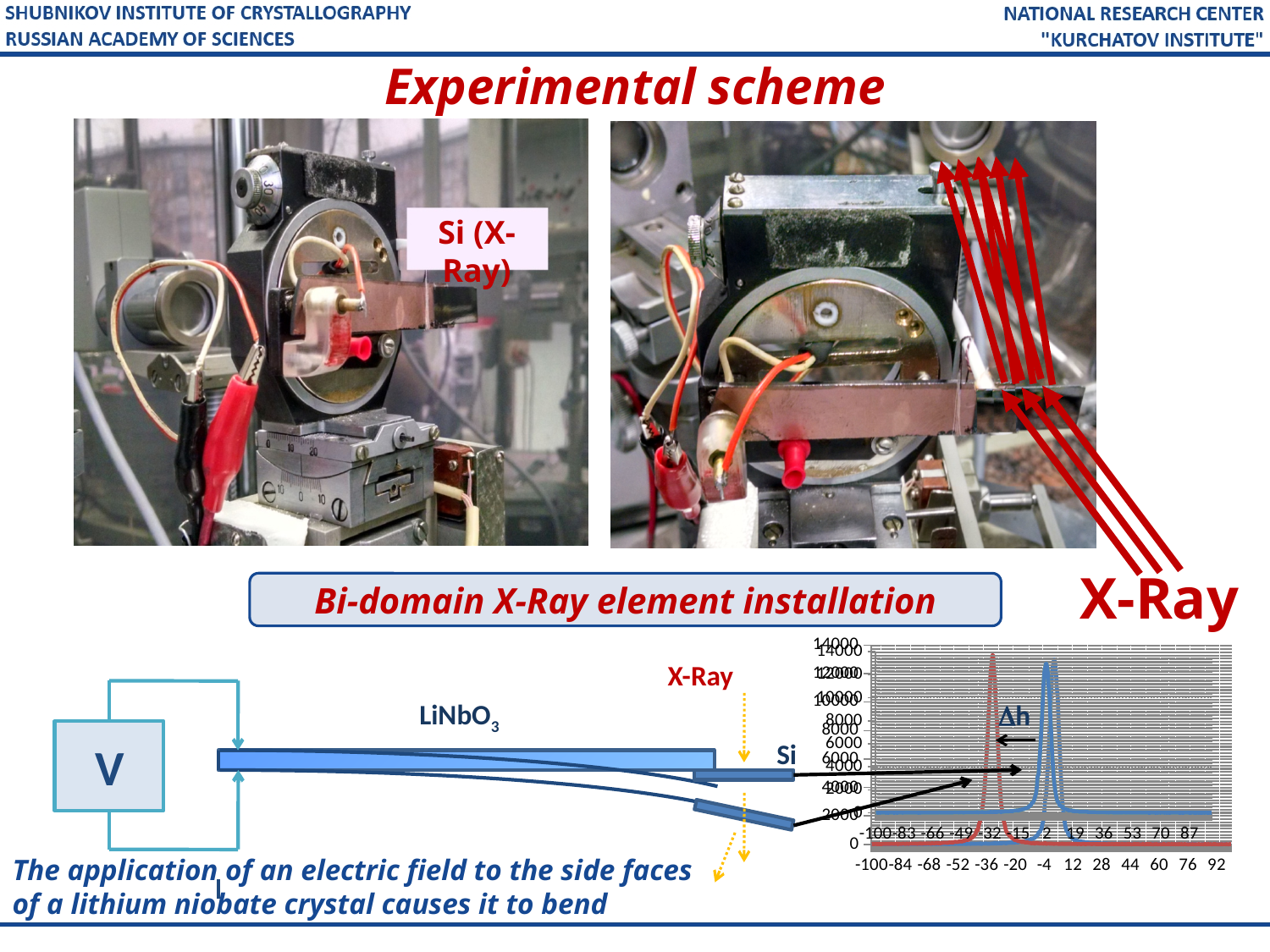
On the chart at the bottom right, what label is written next to the arrow between the two peaks? Δh On the chart at the bottom right, which curve reaches a higher peak, the red dashed curve or the blue solid curve? red dashed curve What kind of chart is shown at the bottom right of the slide? line chart On the chart at the bottom right, is the peak of the blue solid curve greater or less than 6000? greater On the chart at the bottom right, is the peak of the red dashed curve greater or less than 10000? greater On the chart at the bottom right, which curve has its peak further to the left along the x axis, the red dashed curve or the blue solid curve? red dashed curve On the chart at the bottom right, what is the highest value shown on the y axis? 14000 How many curves are plotted on the chart at the bottom right of the slide? 2